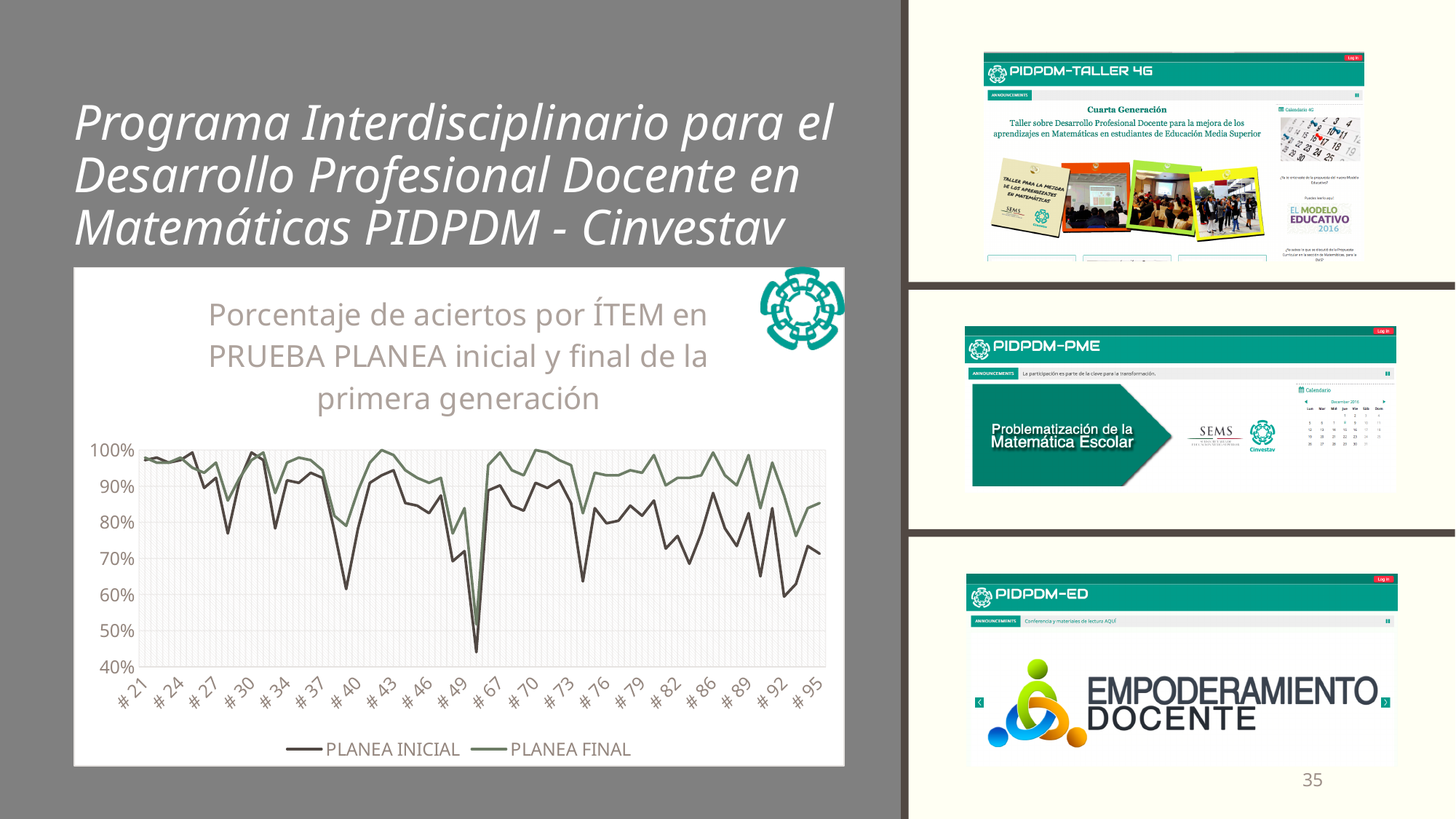
What kind of chart is shown on the slide? line chart Is the value for PLANEA FINAL at # 95 greater or less than 80%? greater What is the title of the chart? Porcentaje de aciertos por ÍTEM en PRUEBA PLANEA inicial y final de la primera generación Is the value for PLANEA INICIAL at # 40 greater or less than 70%? greater How many series does the chart's legend list? 2 At # 95, which series has the larger value, PLANEA INICIAL or PLANEA FINAL? PLANEA FINAL Does the PLANEA INICIAL line ever drop below 50%? yes What are the two series named in the chart's legend? PLANEA INICIAL and PLANEA FINAL Which series reaches the lowest value anywhere on the chart? PLANEA INICIAL At # 40, which series has the larger value, PLANEA INICIAL or PLANEA FINAL? PLANEA FINAL